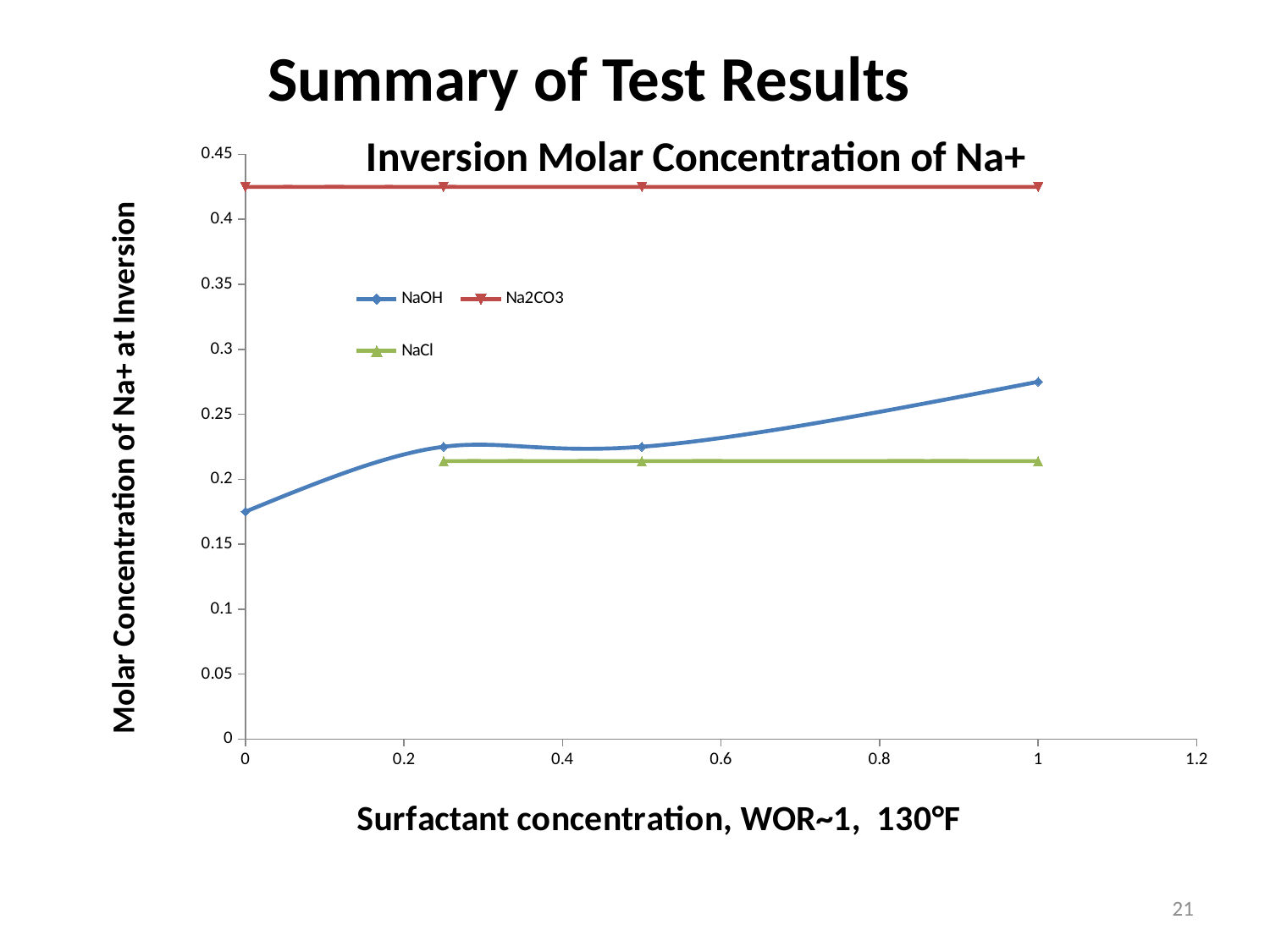
What is the x-axis title of the chart? Surfactant concentration, WOR~1, 130°F Is the value for NaOH at a surfactant concentration of 0 greater or less than 0.15? greater Which series has the lowest value at a surfactant concentration of 1? NaCl At a surfactant concentration of 1, which series has the larger value, NaOH or Na2CO3? Na2CO3 Is the value for Na2CO3 at a surfactant concentration of 0.5 greater or less than 0.4? greater What is the title of the chart? Inversion Molar Concentration of Na+ Does the NaOH series rise or fall as surfactant concentration increases from 0 to 1? rise Is the value for NaCl at a surfactant concentration of 1 greater or less than 0.25? less What kind of chart is shown on the slide? line chart How many series does the chart legend list? 3 Which series has the highest values across the chart? Na2CO3